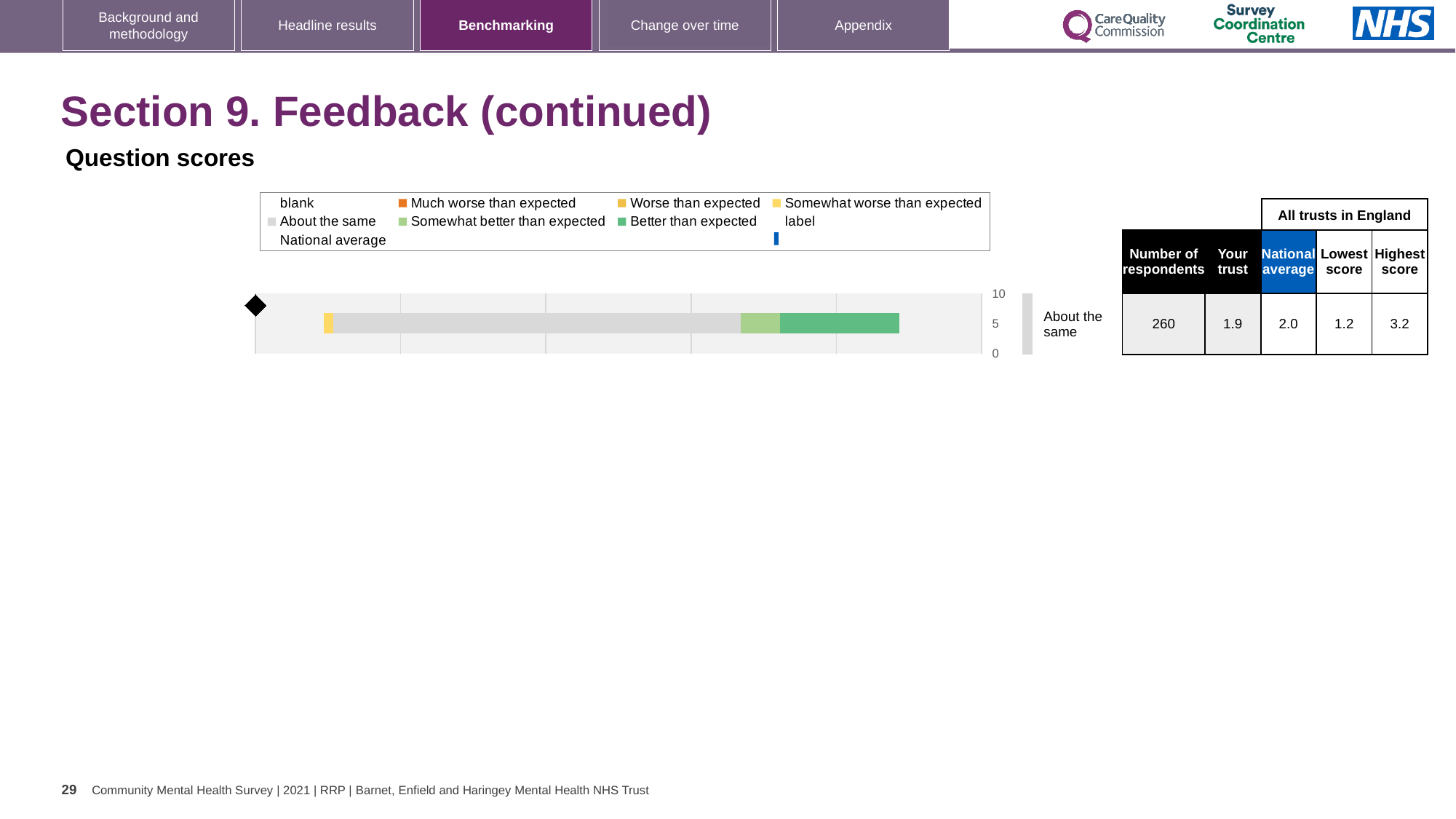
What is the highest score among all trusts in England? 3.2 How many bars are plotted in the chart? 1 What is the national average score? 2.0 What is the difference between the highest score and the lowest score among all trusts in England? 2.0 What benchmark category label is shown next to the bar? About the same What is the difference between the national average and the 'Your trust' score? 0.1 What is the score for 'Your trust'? 1.9 Which is larger, the 'Your trust' score or the national average? National average What is the lowest score among all trusts in England? 1.2 What kind of chart is shown on the slide? bar chart Which colour does the legend use for 'Better than expected'? green What is the number of respondents shown for this question? 260